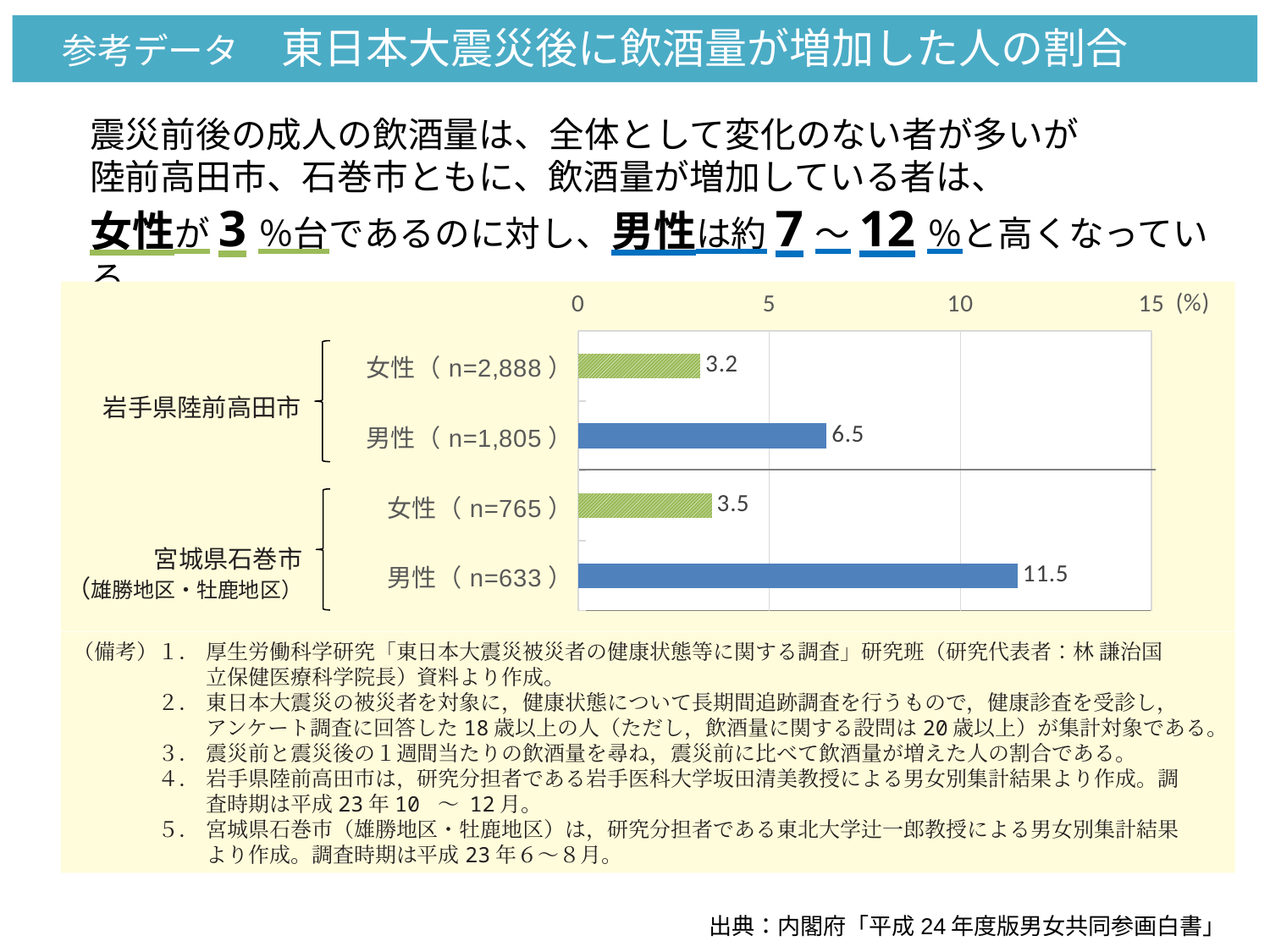
What is the value for 男性 (n=633) in 宮城県石巻市? 11.5 What is the difference between the 男性 and 女性 values for 岩手県陸前高田市? 3.3 Is the value for 男性 (n=633) in 宮城県石巻市 greater or less than 10? greater What is the value for 女性 (n=2,888) in 岩手県陸前高田市? 3.2 What kind of chart is shown on the slide? bar chart Which bar has the highest value? 男性 (n=633) in 宮城県石巻市 What is the value for 男性 (n=1,805) in 岩手県陸前高田市? 6.5 How many bars are plotted in the chart? 4 Which bar has the lowest value? 女性 (n=2,888) in 岩手県陸前高田市 Which is larger: the 男性 value for 岩手県陸前高田市 or the 男性 value for 宮城県石巻市? 宮城県石巻市 What is the value for 女性 (n=765) in 宮城県石巻市? 3.5 What is the difference between the 男性 and 女性 values for 宮城県石巻市? 8.0